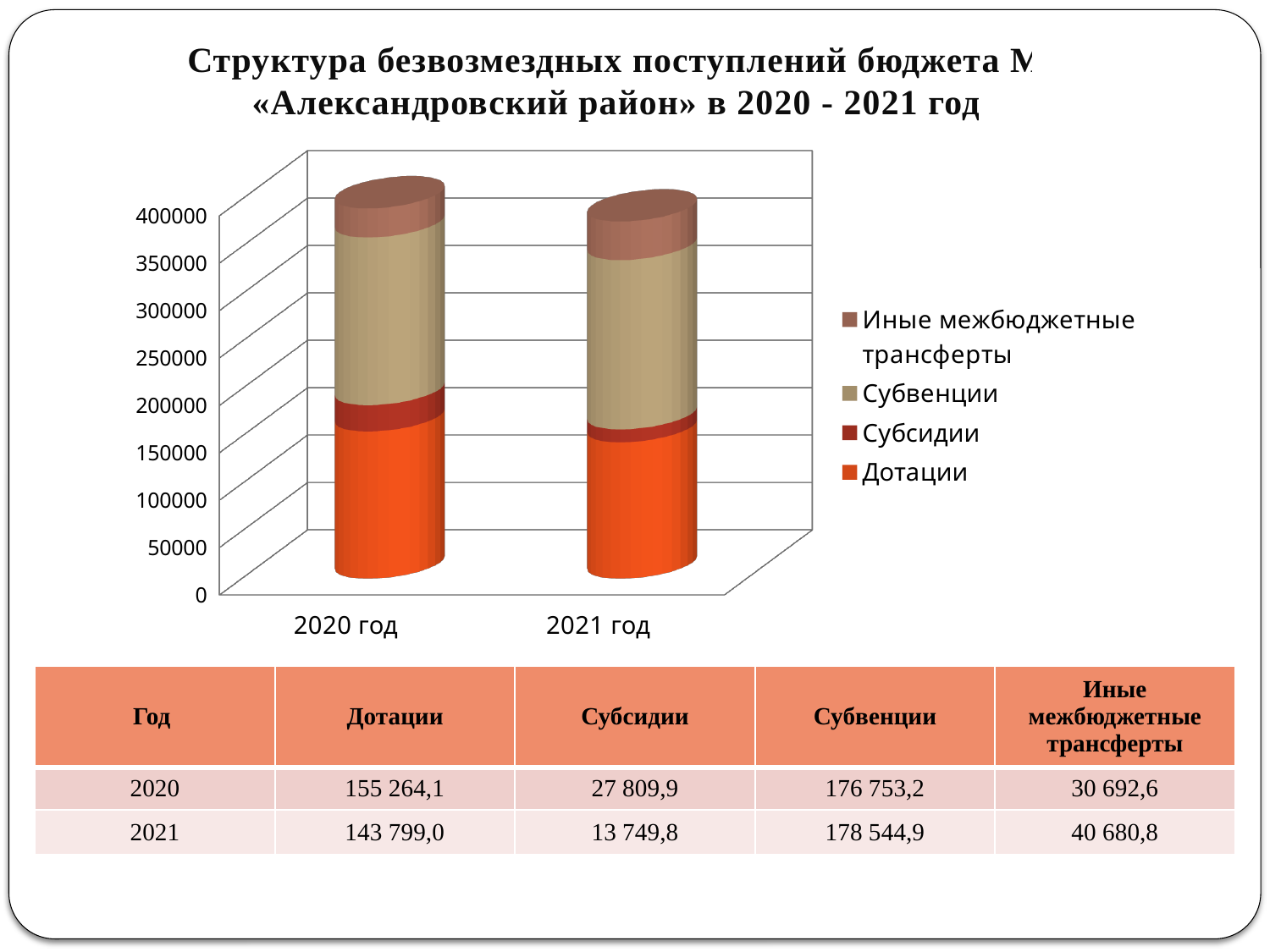
Which series has the smallest value in 2021? Субсидии What type of chart is shown on the slide? Stacked bar chart How many series does the chart legend list? 4 What is the total of the stacked bar for 2020 год, using the values in the table? 390 519,8 According to the table, what is the value of Субсидии for 2021? 13 749,8 How many categories (years) are plotted on the x axis of the chart? 2 According to the table, what is the value of Дотации for 2020? 155 264,1 Which series has the largest value in 2021? Субвенции Is the total height of the stacked bar for 2021 год greater or less than 350000? greater According to the table, what is the value of Иные межбюджетные трансферты for 2021? 40 680,8 Which year has the larger value for Дотации, 2020 or 2021? 2020 By how much did Субсидии decrease from 2020 to 2021? 14 060,1